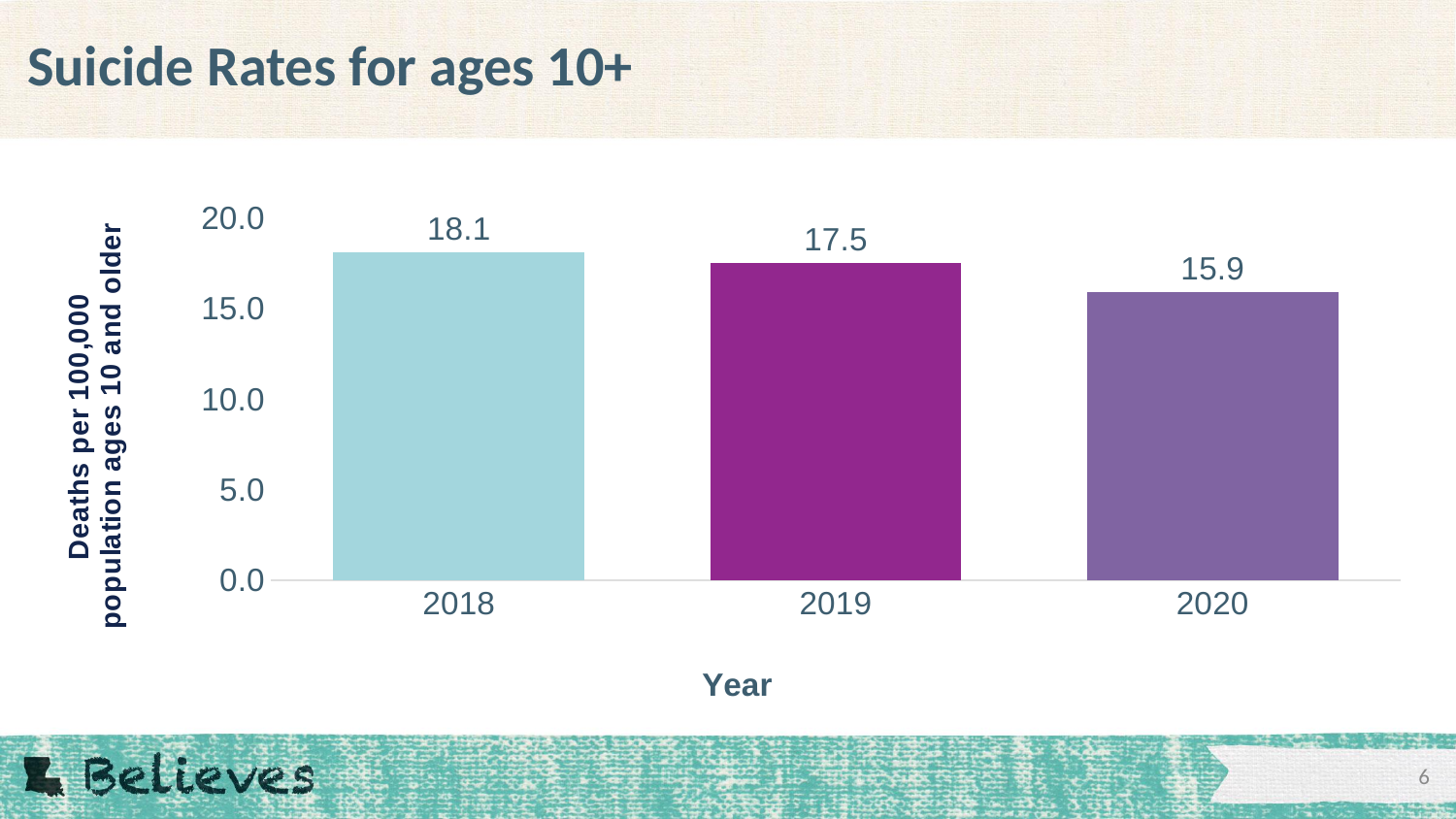
How many years are shown on the chart? 3 What is the suicide rate for 2019? 17.5 What is the difference between the suicide rates for 2018 and 2020? 2.2 What kind of chart is shown on the slide? Bar chart What is the difference between the suicide rates for 2019 and 2020? 1.6 What is the suicide rate for 2020? 15.9 Which year has a higher suicide rate, 2019 or 2020? 2019 Which year has the highest suicide rate? 2018 Is the value for 2020 greater or less than 15.0? greater Do the suicide rates rise or fall from 2018 to 2020? Fall What is the suicide rate for 2018? 18.1 Which year has the lowest suicide rate? 2020